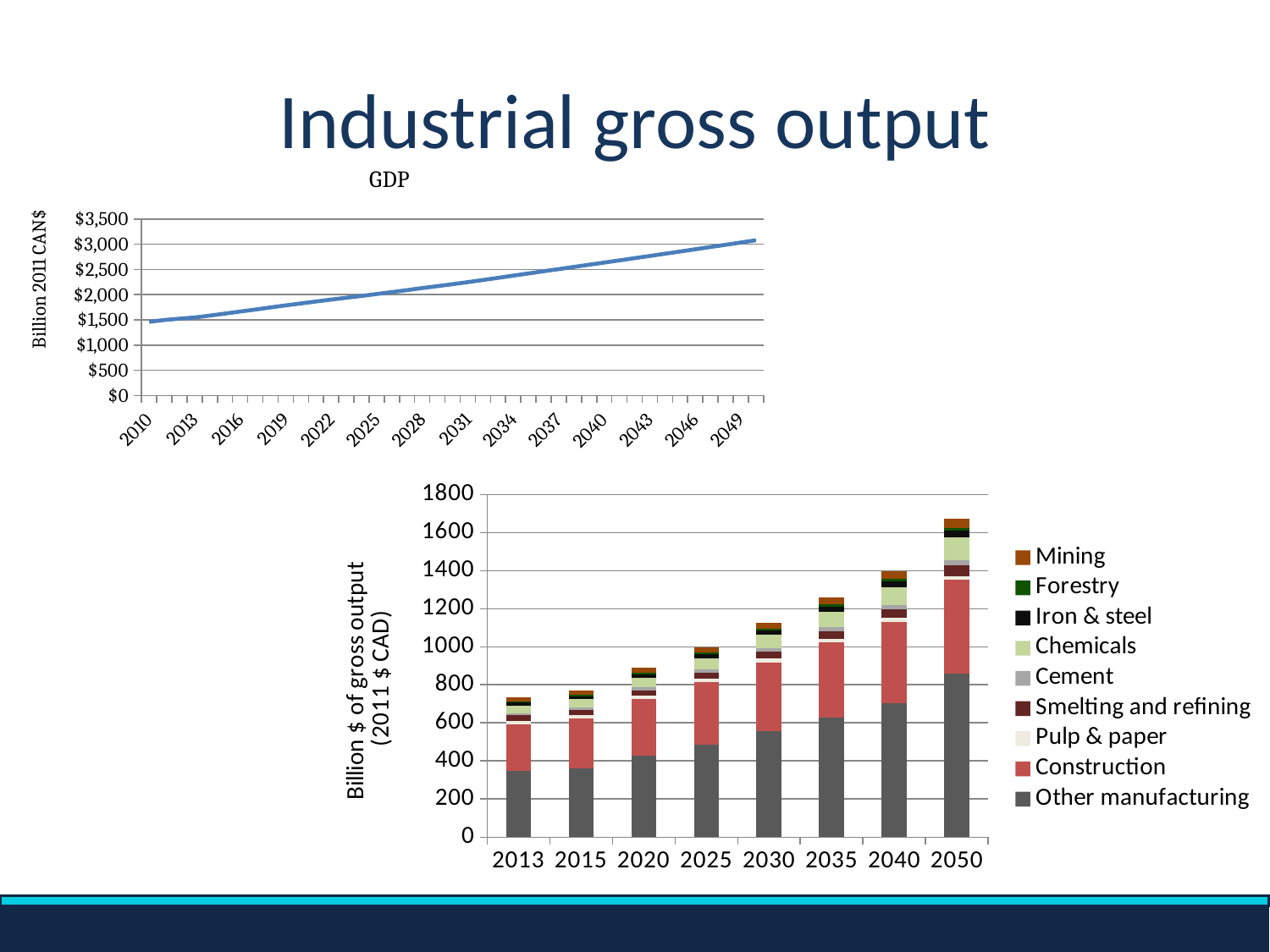
In the top chart titled "GDP", is the value for 2049 greater or less than $2,500? greater In the top chart titled "GDP", is the value for 2010 greater or less than $2,000? less What kind of chart is the bottom chart showing gross output by sector? stacked bar chart How many years are shown on the x axis of the bottom chart? 8 In the bottom chart, which year has the highest total gross output? 2050 In the top chart titled "GDP", does the value rise or fall from 2010 to 2049? rise In the bottom chart, is the total gross output for 2013 greater or less than 800? less What is the y-axis label of the top chart titled "GDP"? Billion 2011 CAN$ What kind of chart is the top chart titled "GDP"? line chart How many series does the legend of the bottom chart list? 9 In the bottom chart, which year has the lowest total gross output? 2013